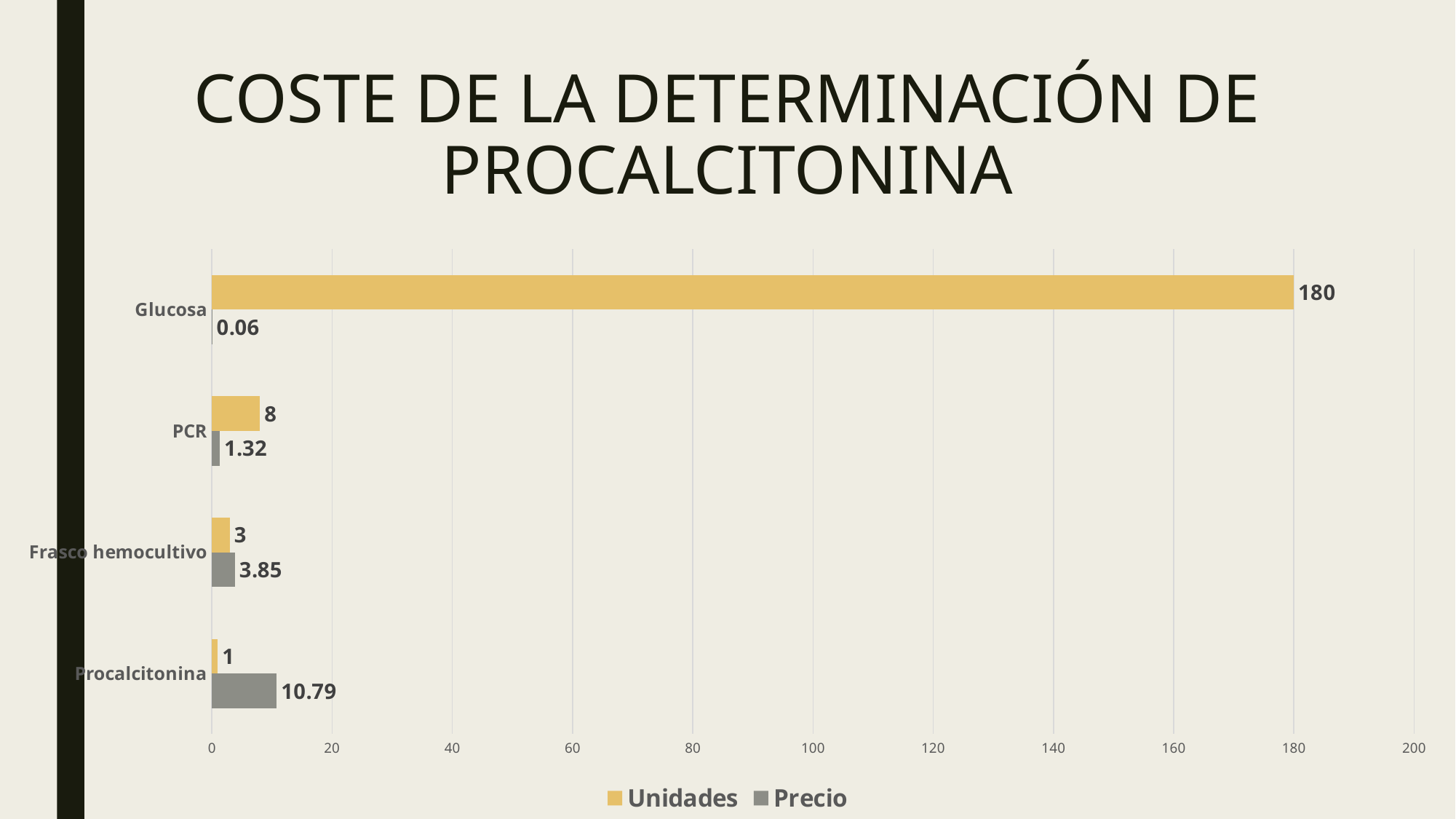
What is the Unidades value for Frasco hemocultivo? 3 How many series does the legend list? 2 Which category has the lowest Precio value? Glucosa What is the difference between the Precio values for Procalcitonina and Frasco hemocultivo? 6.94 Which is larger, the Precio for Frasco hemocultivo or the Precio for PCR? Frasco hemocultivo What is the Unidades value for Glucosa? 180 How many categories are shown on the chart? 4 What is the Precio value for Procalcitonina? 10.79 What is the difference between the Unidades values for Glucosa and PCR? 172 What is the Precio value for PCR? 1.32 What kind of chart is shown on the slide? Bar chart Which category has the highest Unidades value? Glucosa